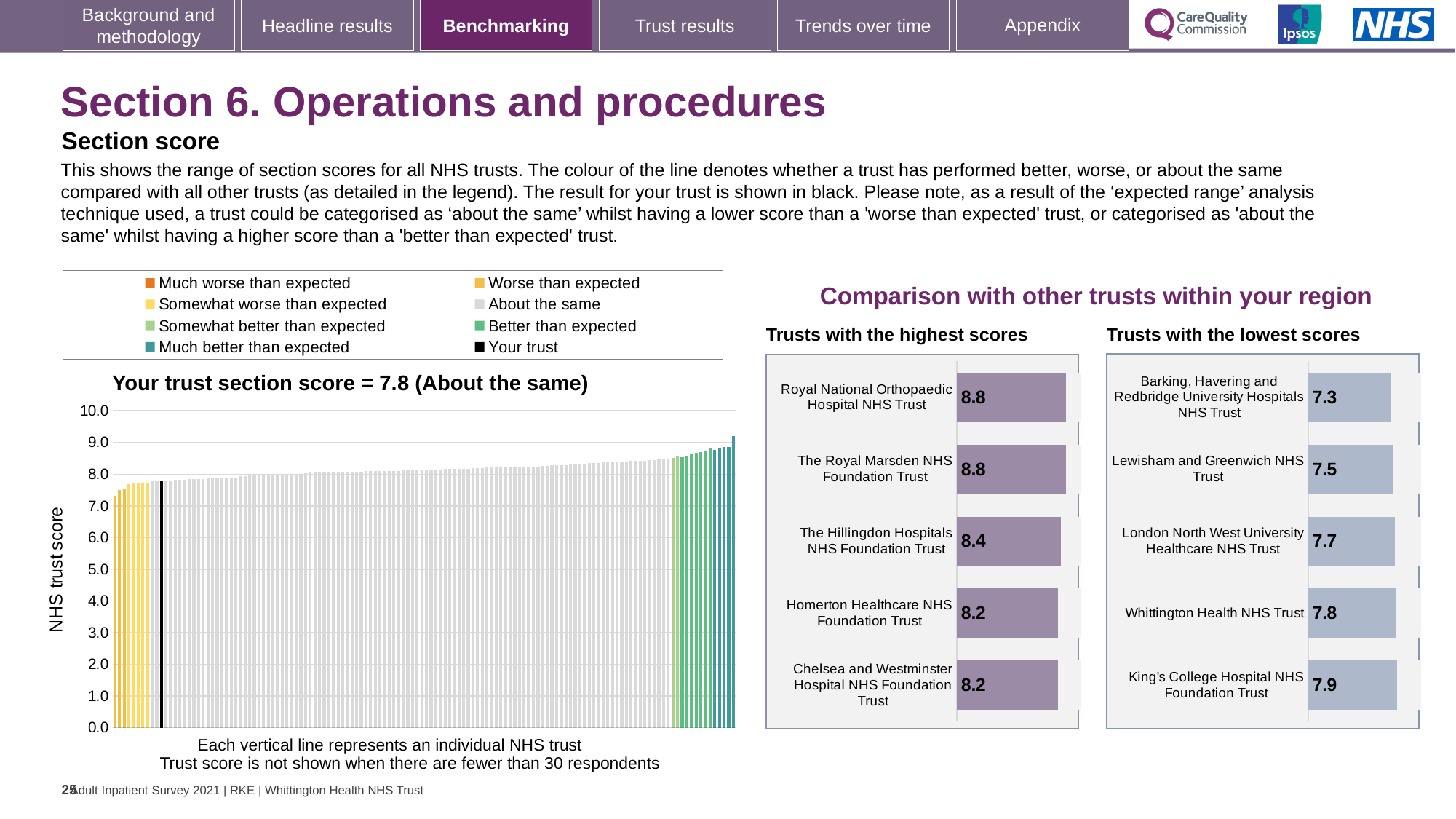
In the 'Trusts with the lowest scores' chart, which trust has the highest score? King's College Hospital NHS Foundation Trust In the 'Your trust section score' chart, do the trust scores rise or fall from left to right? Rise What type of chart is the 'Your trust section score' chart? Bar chart How many entries does the legend above the 'Your trust section score' chart list? 8 How many trusts are shown in the 'Trusts with the highest scores' chart? 5 In the 'Trusts with the lowest scores' chart, what is the difference between the scores of King's College Hospital NHS Foundation Trust and Barking, Havering and Redbridge University Hospitals NHS Trust? 0.6 Which has the higher score: Homerton Healthcare NHS Foundation Trust in the 'highest scores' chart or Whittington Health NHS Trust in the 'lowest scores' chart? Homerton Healthcare NHS Foundation Trust In the 'Trusts with the lowest scores' chart, which trust has the lowest score? Barking, Havering and Redbridge University Hospitals NHS Trust In the 'Trusts with the lowest scores' chart, what is the score for Lewisham and Greenwich NHS Trust? 7.5 In the 'Your trust section score' chart, what is the section score for your trust? 7.8 In the 'Trusts with the highest scores' chart, what is the score for The Hillingdon Hospitals NHS Foundation Trust? 8.4 In the 'Trusts with the highest scores' chart, what is the difference between the scores of The Royal Marsden NHS Foundation Trust and The Hillingdon Hospitals NHS Foundation Trust? 0.4